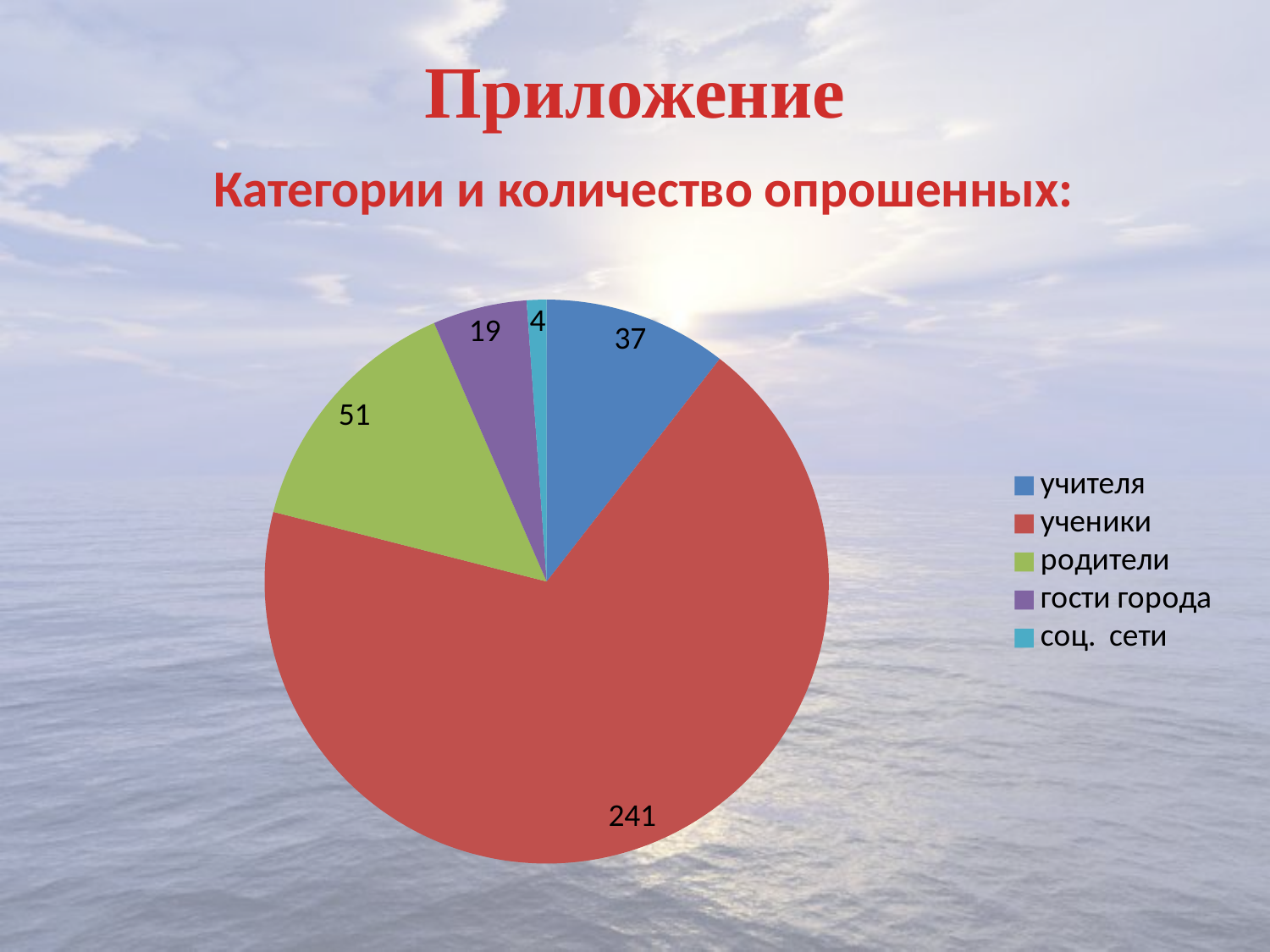
What is the difference between the values for родители and учителя? 14 What is the value for учителя in the pie chart? 37 What is the value for родители in the pie chart? 51 Which category has the smallest slice in the pie chart? соц. сети What is the value for гости города in the pie chart? 19 What type of chart is shown on the slide? pie chart What is the title text above the pie chart? Категории и количество опрошенных: What is the total of all values shown in the pie chart? 352 What is the value for ученики in the pie chart? 241 Which is larger, the value for гости города or the value for соц. сети? гости города Which category has the largest slice in the pie chart? ученики How many categories does the pie chart show? 5